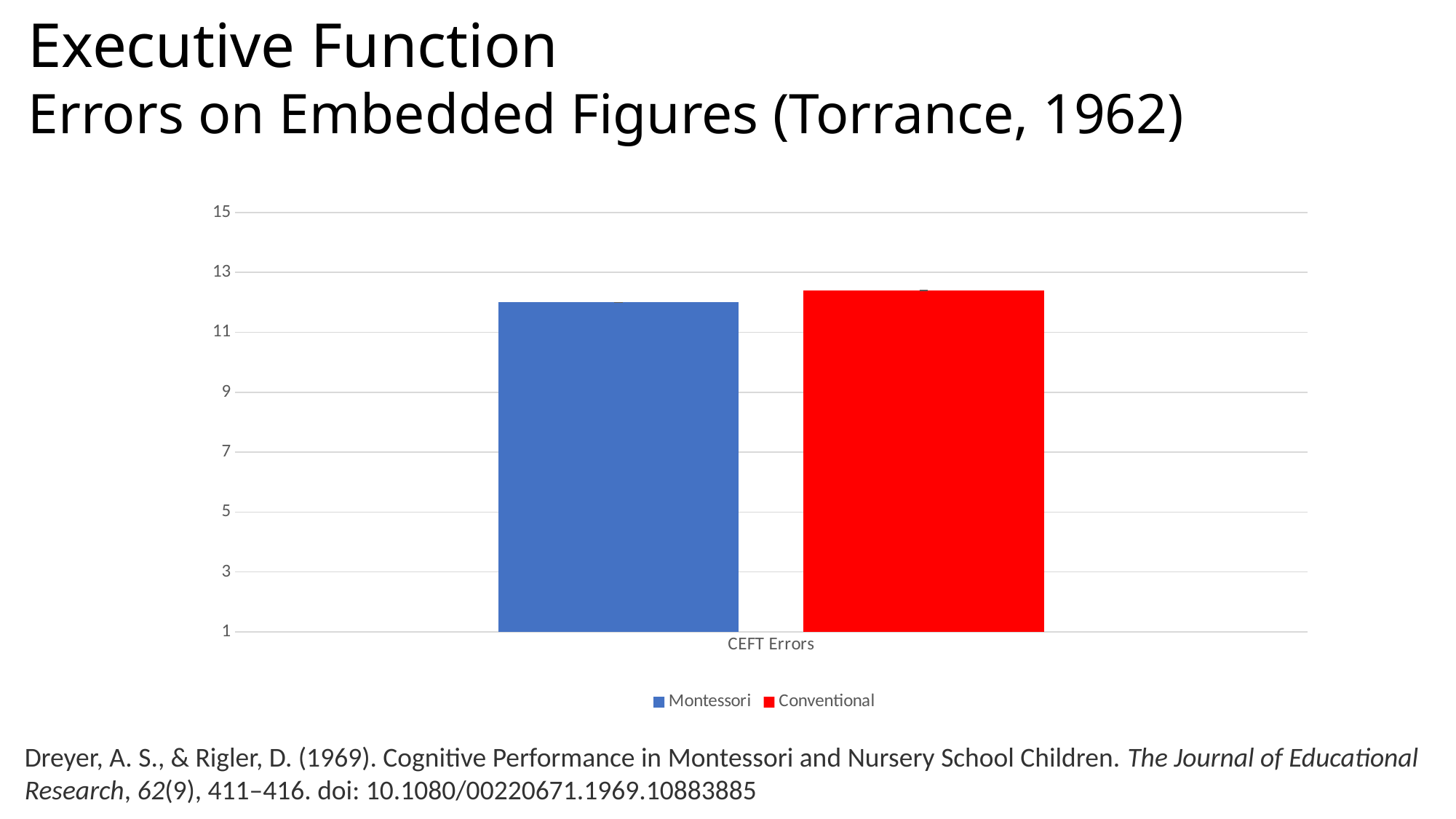
How many categories are shown on the x axis? 1 Is the value for Montessori greater or less than 11? greater Is the value for Montessori greater or less than 13? less What kind of chart is shown on the slide? bar chart Which series is shown in red? Conventional Is the value for Conventional greater or less than 9? greater Which series has the higher value for CEFT Errors, Montessori or Conventional? Conventional How many series does the legend list? 2 What is the category label on the x axis? CEFT Errors